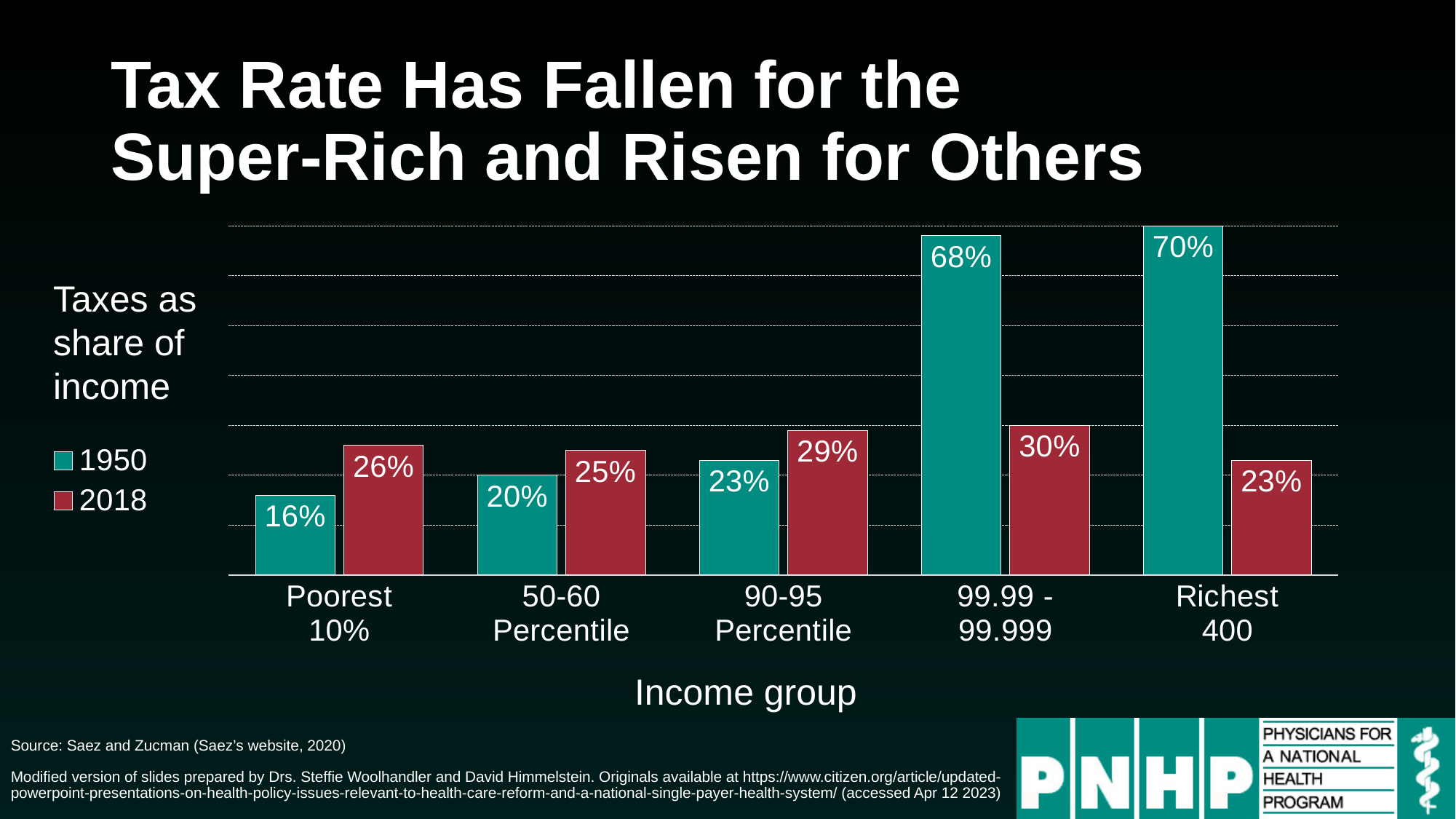
By how many percentage points did the tax rate for the Richest 400 fall between 1950 and 2018? 47 What is the label of the x axis? Income group What was the tax rate for the 99.99 - 99.999 group in 2018? 30% For the 50-60 Percentile group, was the tax rate higher in 1950 or 2018? 2018 What was the tax rate as a share of income for the Richest 400 in 1950? 70% What type of chart is shown on the slide? Bar chart Which income group had the highest tax rate in 1950? Richest 400 How many series does the legend list? 2 What is the difference between the 2018 and 1950 tax rates for the 90-95 Percentile group? 6% Which income group had the lowest tax rate in 2018? Richest 400 How many income groups are shown on the chart? 5 What was the tax rate as a share of income for the Poorest 10% in 2018? 26%